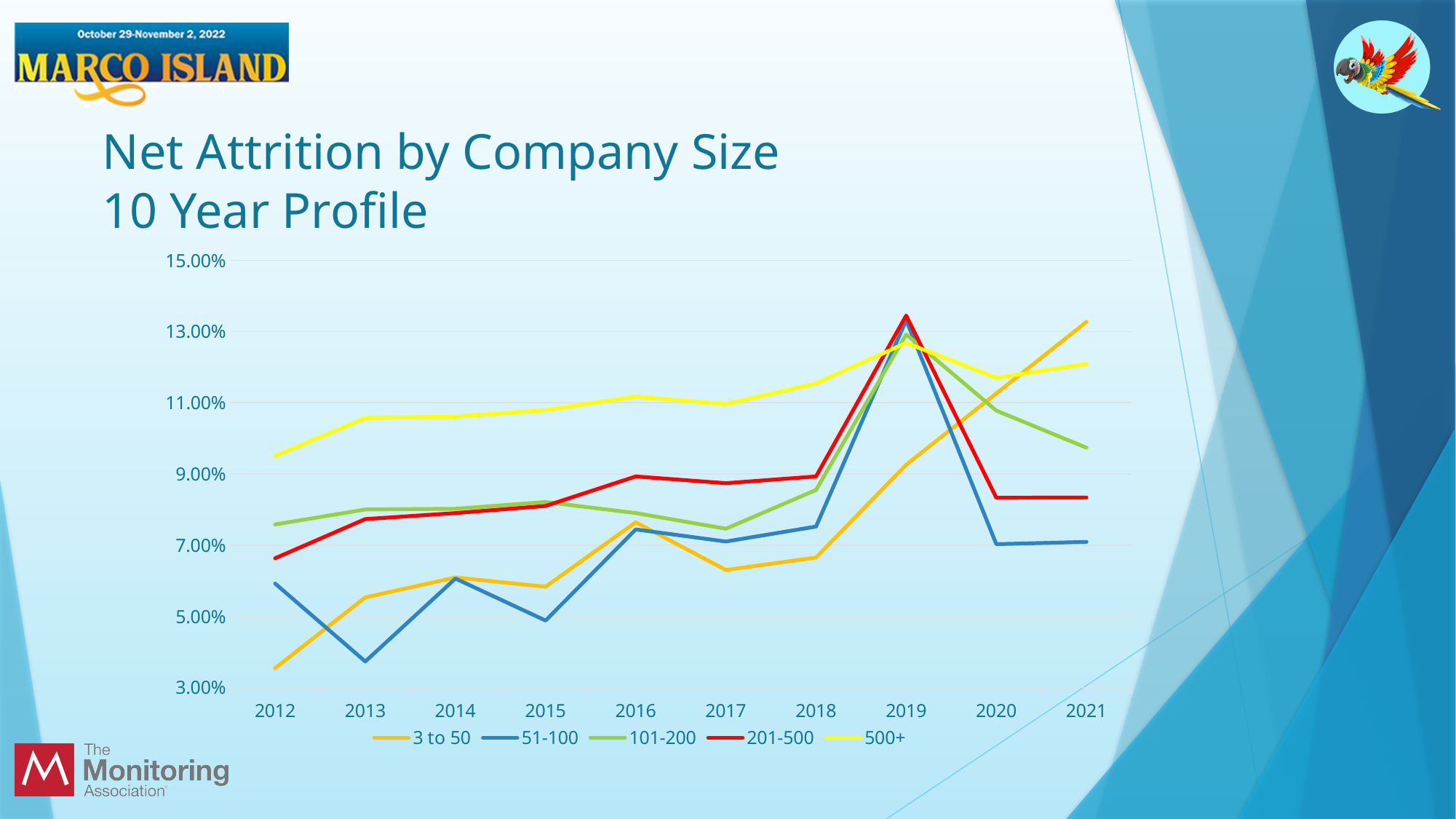
Which company size series has the lowest net attrition in 2012? 3 to 50 Is the value for the 500+ series in 2012 greater or less than 9.00%? greater In which year does the 201-500 series reach its highest value? 2019 How many series does the legend list? 5 What kind of chart is shown on the slide? Line chart Which company size series has the lowest net attrition in 2021? 51-100 Is the value for the 51-100 series in 2013 greater or less than 5.00%? less What is the title of the chart on the slide? Net Attrition by Company Size 10 Year Profile Does the 3 to 50 series rise or fall from 2019 to 2021? rise How many years are plotted along the x axis? 10 Which company size series has the highest net attrition in 2012? 500+ Which company size series has the highest net attrition in 2021? 3 to 50